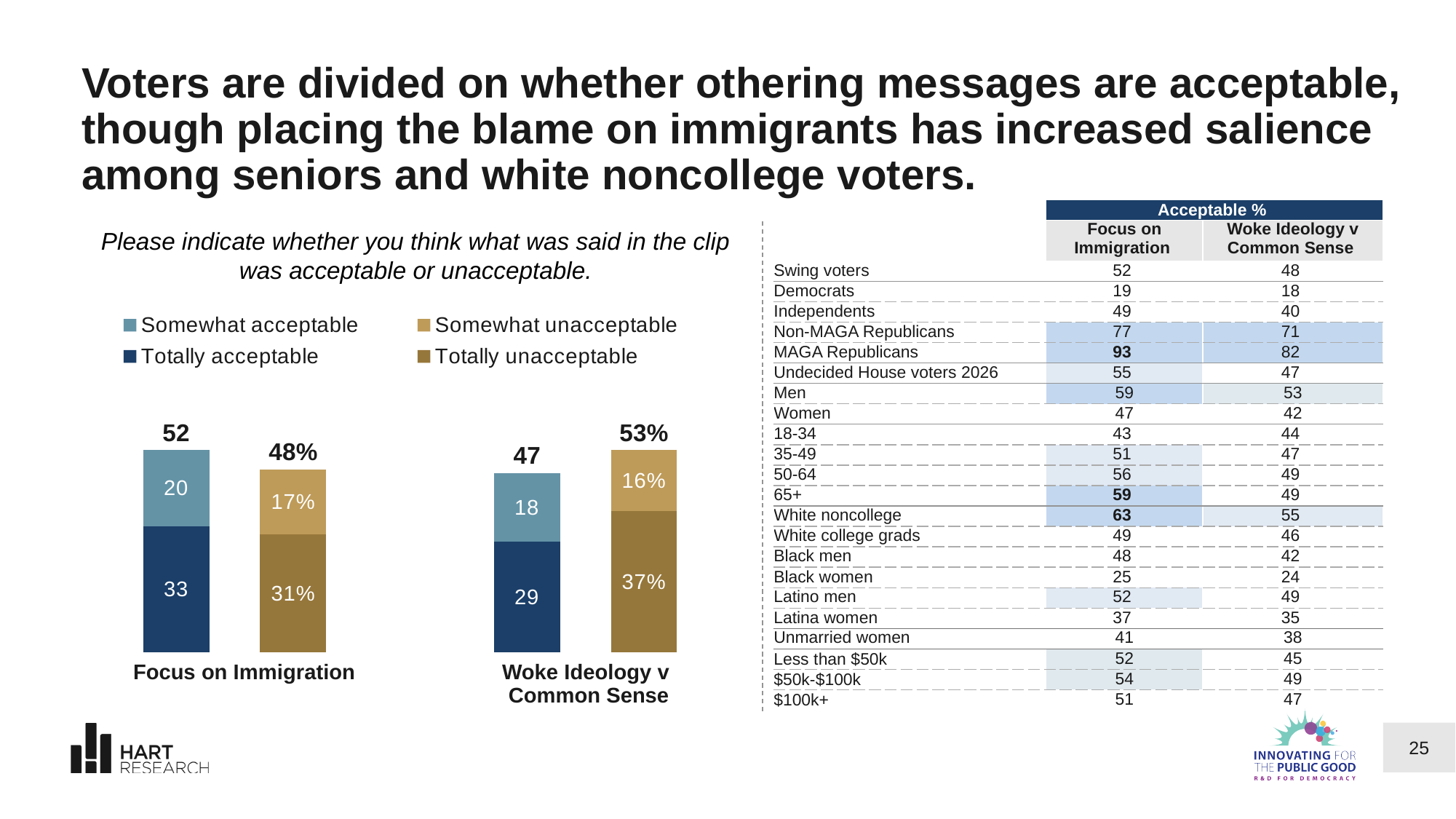
What kind of chart is shown on the left of the slide? Stacked bar chart Which message has the higher total acceptable value, Focus on Immigration or Woke Ideology v Common Sense? Focus on Immigration What is the difference between the Totally unacceptable values for Woke Ideology v Common Sense and Focus on Immigration? 6% What is the Totally unacceptable value for Woke Ideology v Common Sense? 37% What is the difference between the Totally acceptable values for Focus on Immigration and Woke Ideology v Common Sense? 4 What is the Somewhat unacceptable value for Focus on Immigration? 17% Which colour represents Totally acceptable in the chart legend? Dark blue How many series does the chart legend list? 4 What is the Somewhat acceptable value for Woke Ideology v Common Sense? 18 What is the total acceptable share for Focus on Immigration? 52 What is the total unacceptable share for Woke Ideology v Common Sense? 53% What is the Totally acceptable value for Focus on Immigration? 33